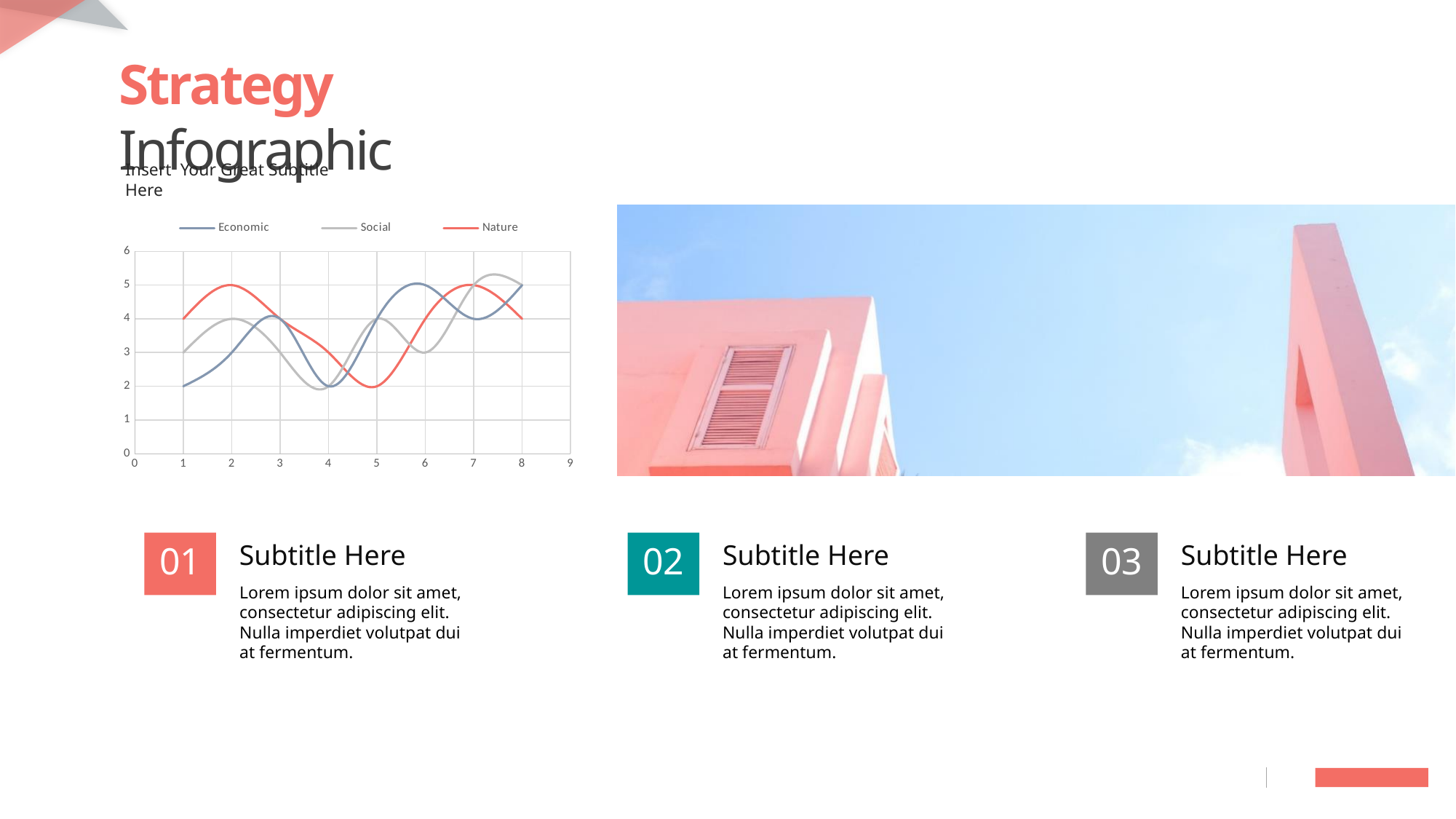
What is the value of the Economic series at x = 6? 5 What are the three series named in the chart's legend? Economic, Social, Nature What kind of chart is shown on the slide? line chart What is the value of the Nature series at x = 5? 2 At x = 2, which series has the larger value, Economic or Nature? Nature What is the value of the Economic series at x = 1? 2 How many series does the chart's legend list? 3 Is the value of the Nature series at x = 2 greater or less than 4? greater What is the value of the Nature series at x = 2? 5 Is the value of the Economic series at x = 1 greater or less than 3? less Which series in the chart is drawn in red? Nature At x = 5, which series has the larger value, Social or Nature? Social